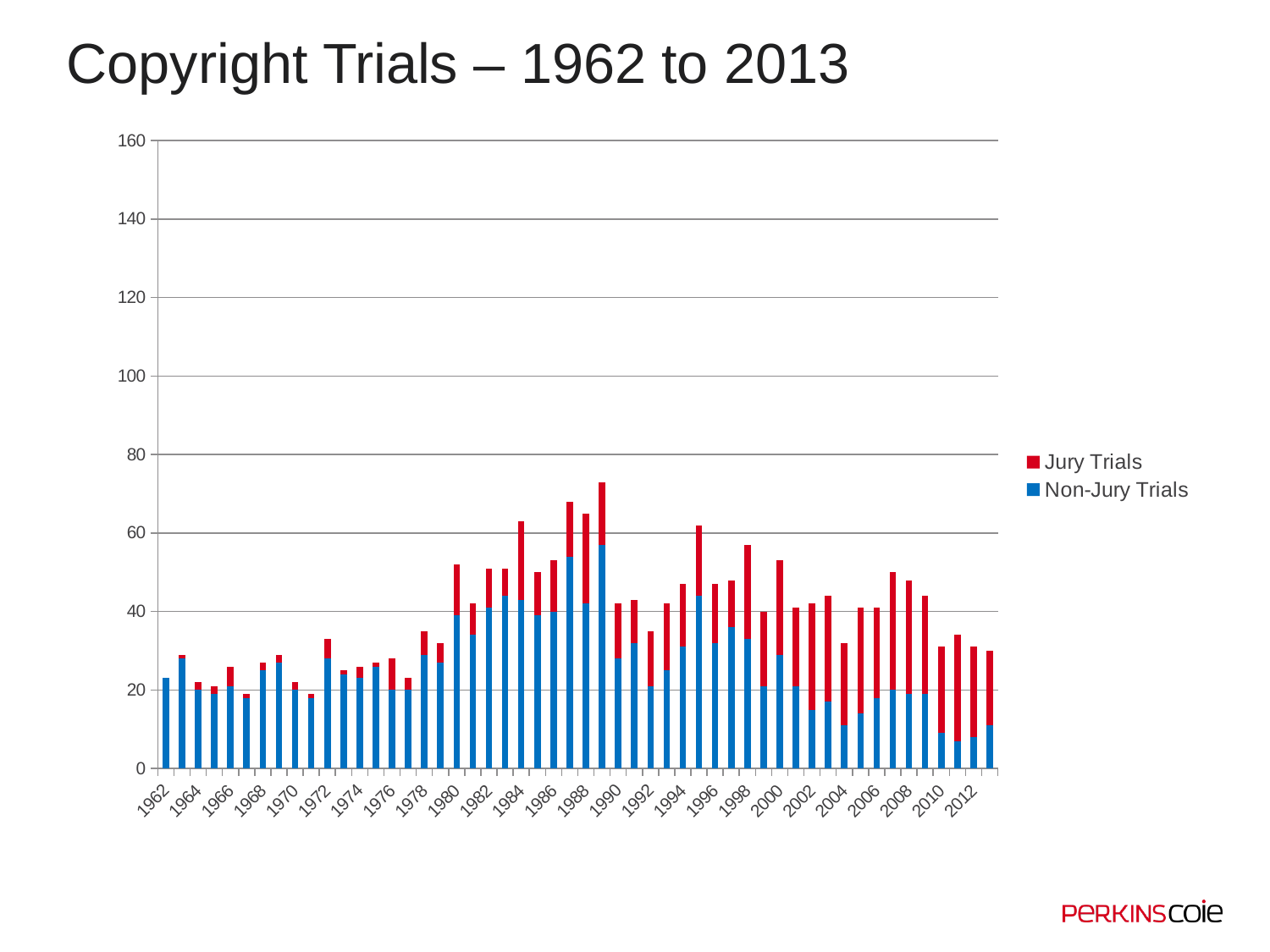
Which colour represents Jury Trials in the chart? red What are the two series named in the legend? Jury Trials and Non-Jury Trials From 2008 to 2013, do the total numbers of trials generally rise or fall? fall Is the total number of trials in 2011 greater or less than 40? less Is the total number of trials in 1980 greater or less than 40? greater Is the total number of trials in 1989 greater or less than 60? greater Which year has the larger total number of trials, 1989 or 1962? 1989 Which year has the highest total number of copyright trials? 1989 What kind of chart is shown on the slide? stacked bar chart How many years (bars) are plotted in the chart? 52 How many series does the legend list? 2